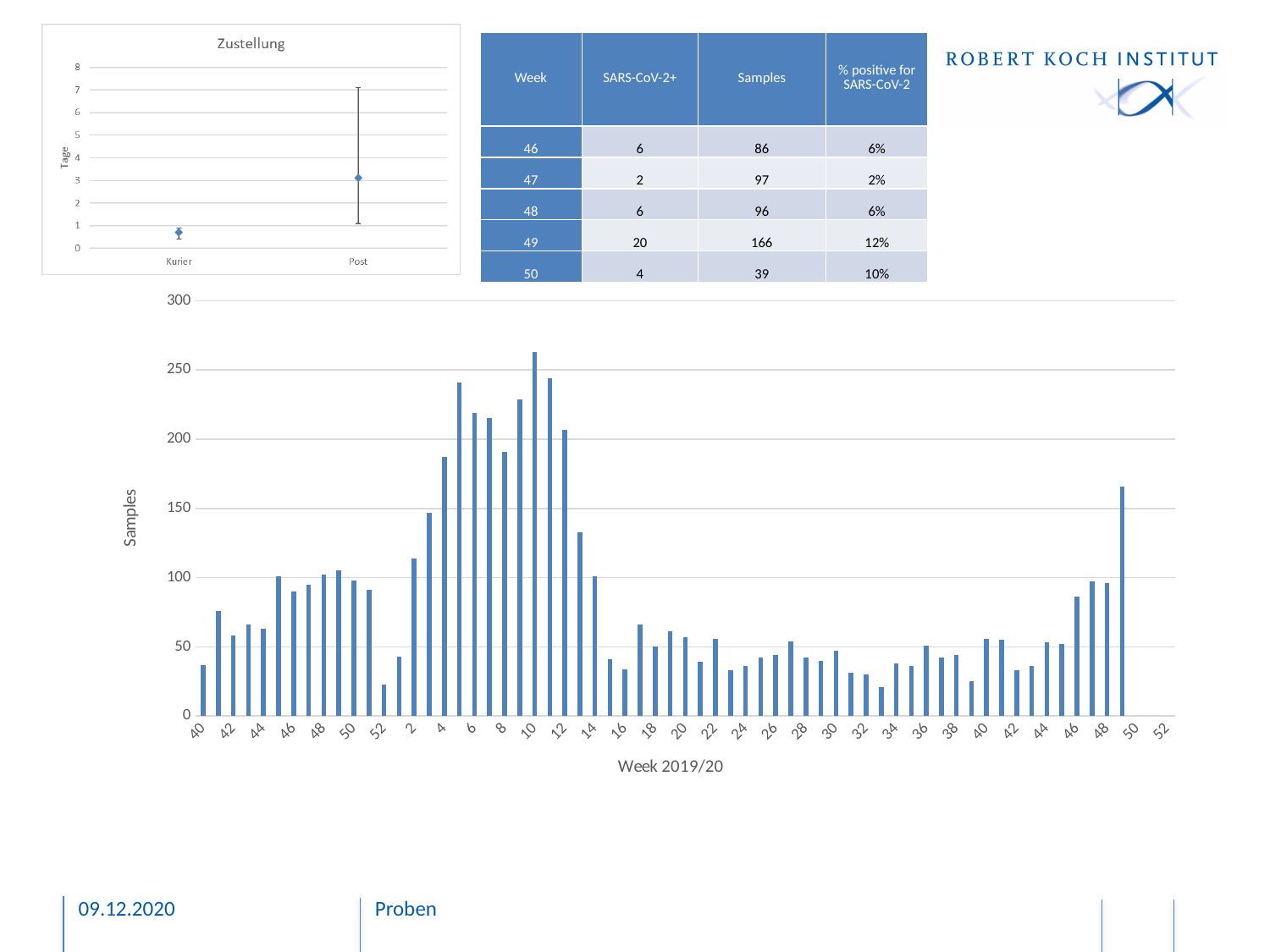
In the bottom bar chart, which week has the highest number of samples? 10 In the 'Zustellung' chart at the top left, which category has the higher plotted value: Kurier or Post? Post What is the label of the x axis of the bottom bar chart? Week 2019/20 In the bottom bar chart, is the value for week 5 greater or less than 200? greater What kind of chart is the large chart at the bottom of the slide? bar chart In the bottom bar chart, do the values rise or fall from week 10 to week 16? fall In the bottom bar chart, is the value for week 10 greater or less than 250? greater In the bottom bar chart, is the value for the last bar (week 49 of 2020) greater or less than 150? greater In the bottom bar chart, which is larger: the value for week 10 or the value for week 11? week 10 In the 'Zustellung' chart at the top left, how many categories are shown on the x axis? 2 In the bottom bar chart, which is larger: the value for week 2 or the value for week 3? week 3